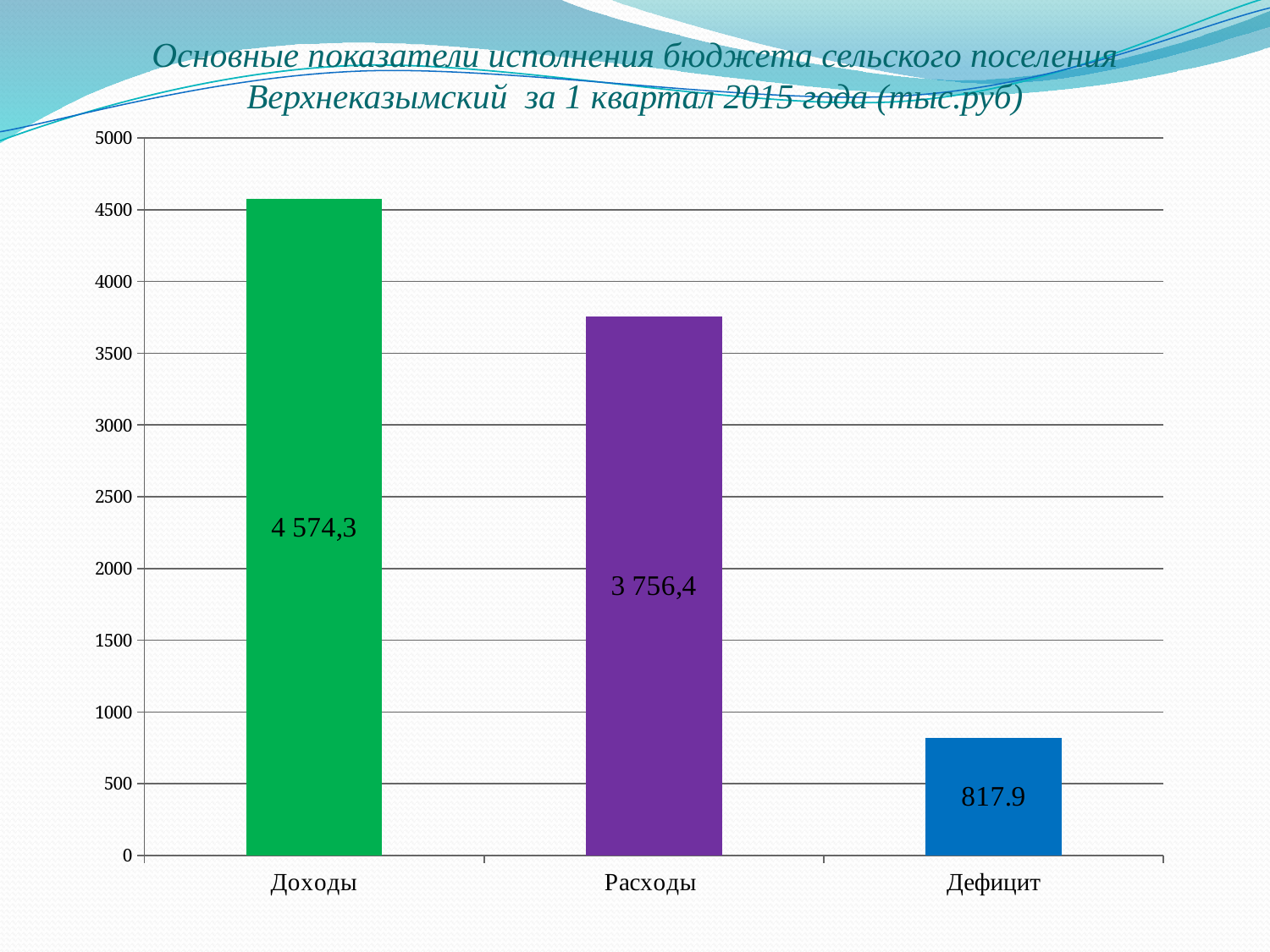
What kind of chart is shown on the slide? bar chart How many categories are shown on the x axis? 3 What is the value for Дефицит? 817.9 Which category has the lowest value? Дефицит What colour is the bar for Расходы? purple Which category has the highest value? Доходы Is the value for Дефицит greater or less than 1000? less Is the value for Расходы greater or less than 3500? greater What is the value for Доходы? 4 574,3 What is the value for Расходы? 3 756,4 Which is larger, the value for Расходы or the value for Дефицит? Расходы What is the difference between the values for Доходы and Расходы? 817,9